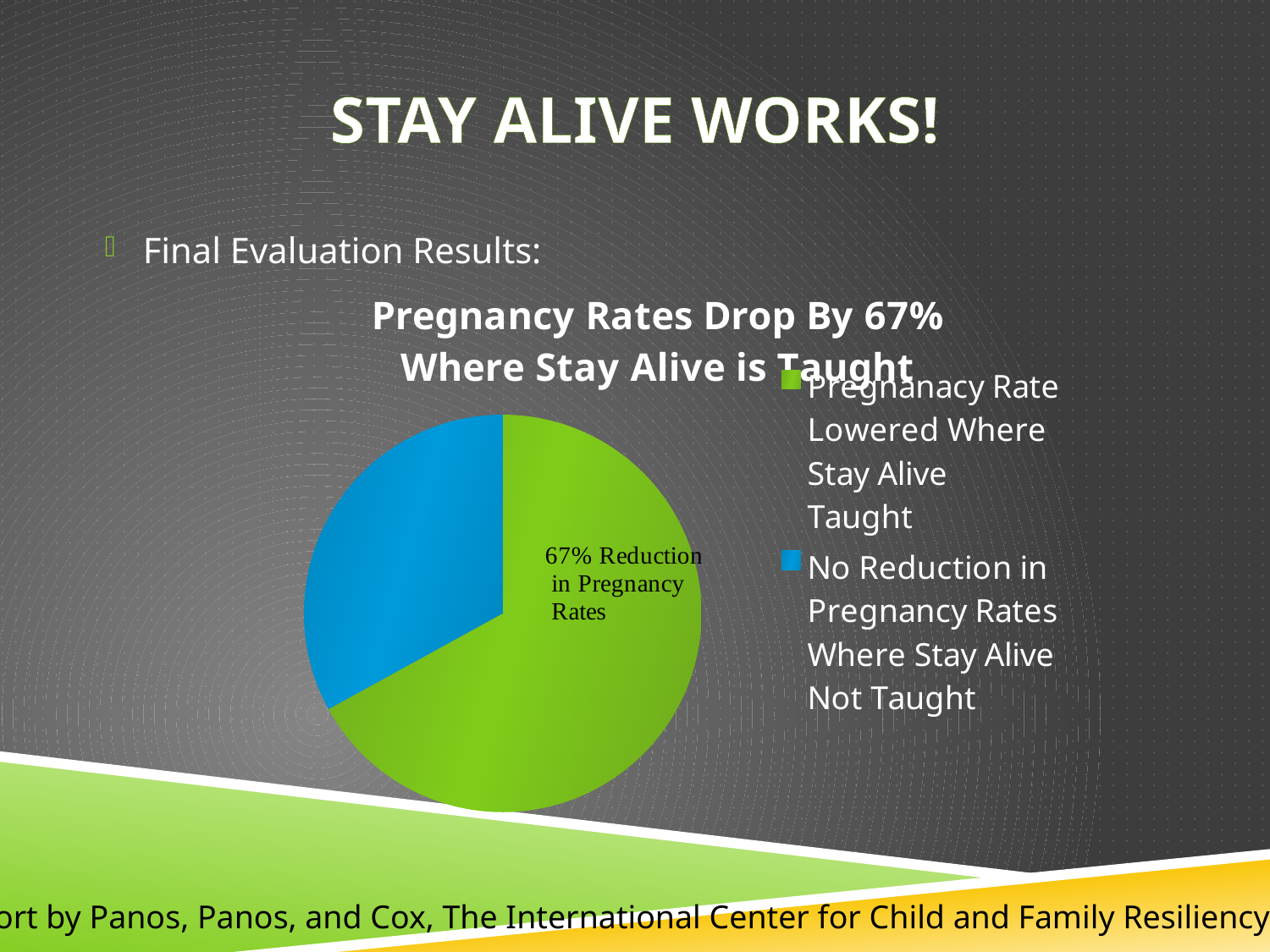
What data label is printed on the green slice of the pie chart? 67% Reduction in Pregnancy Rates Which legend category has the smallest slice of the pie chart? No Reduction in Pregnancy Rates Where Stay Alive Not Taught What share of the pie does the 'Pregnanacy Rate Lowered Where Stay Alive Taught' slice represent? 67% What colour is the 'Pregnanacy Rate Lowered Where Stay Alive Taught' slice in the pie chart? green How many slices does the pie chart have? 2 Which slice is larger: 'Pregnanacy Rate Lowered Where Stay Alive Taught' or 'No Reduction in Pregnancy Rates Where Stay Alive Not Taught'? Pregnanacy Rate Lowered Where Stay Alive Taught Which legend category has the largest slice of the pie chart? Pregnanacy Rate Lowered Where Stay Alive Taught How many entries does the pie chart's legend list? 2 Is the share of the 'Pregnanacy Rate Lowered Where Stay Alive Taught' slice greater or less than 50%? greater What colour is the 'No Reduction in Pregnancy Rates Where Stay Alive Not Taught' slice in the pie chart? blue What kind of chart is shown on the slide? pie chart